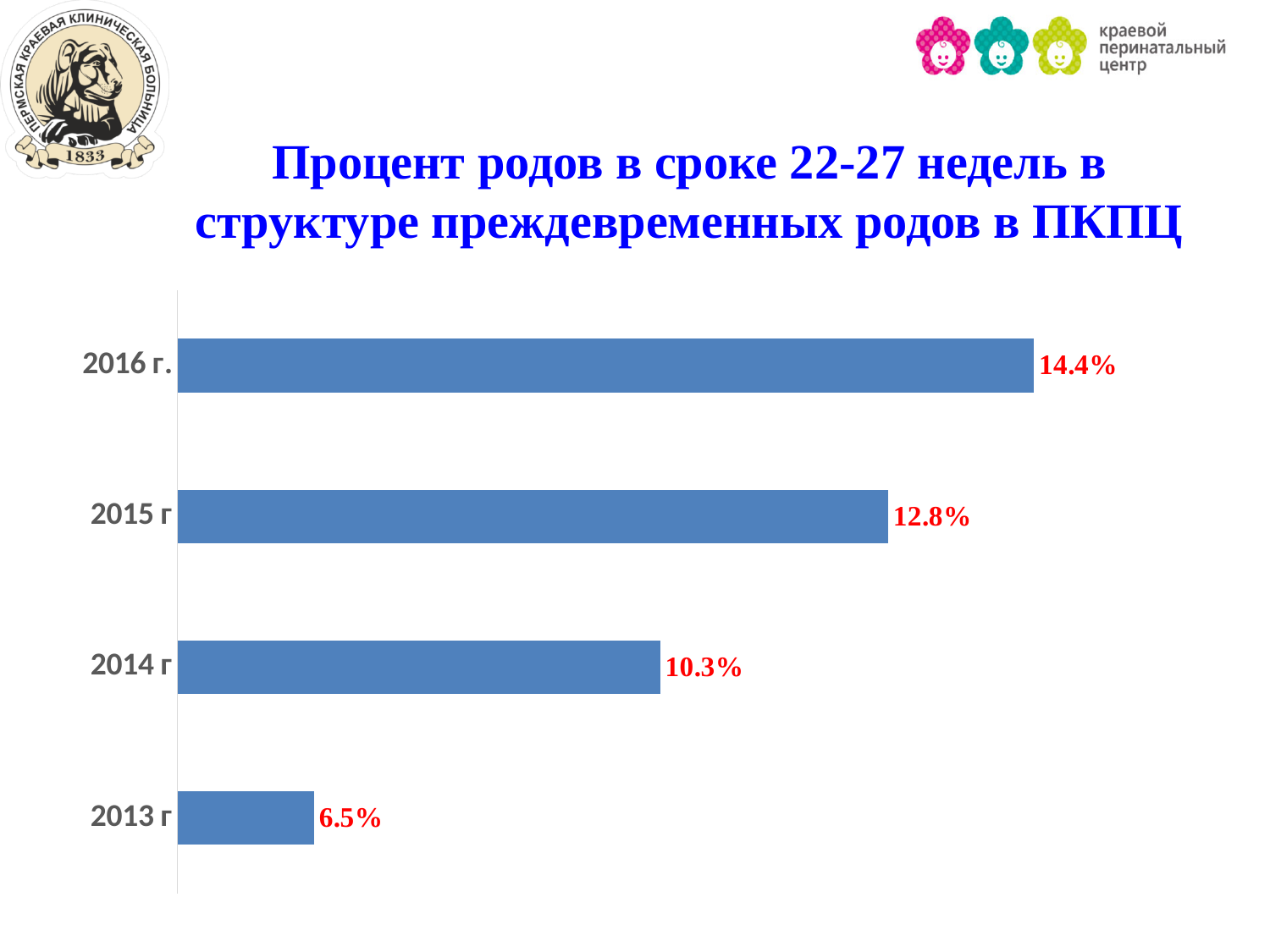
Which year has the lowest value? 2013 г What is the value for 2013 г? 6.5% What is the difference between the values for 2015 г and 2014 г? 2.5% How many years are shown in the chart? 4 What is the value for 2014 г? 10.3% What is the difference between the values for 2016 г. and 2013 г? 7.9% What is the value for 2015 г? 12.8% Which year has the highest value? 2016 г. What is the value for 2016 г.? 14.4% What kind of chart is shown on the slide? Bar chart Do the values rise or fall from 2013 г to 2016 г.? Rise Which is larger, the value for 2014 г or the value for 2015 г? 2015 г